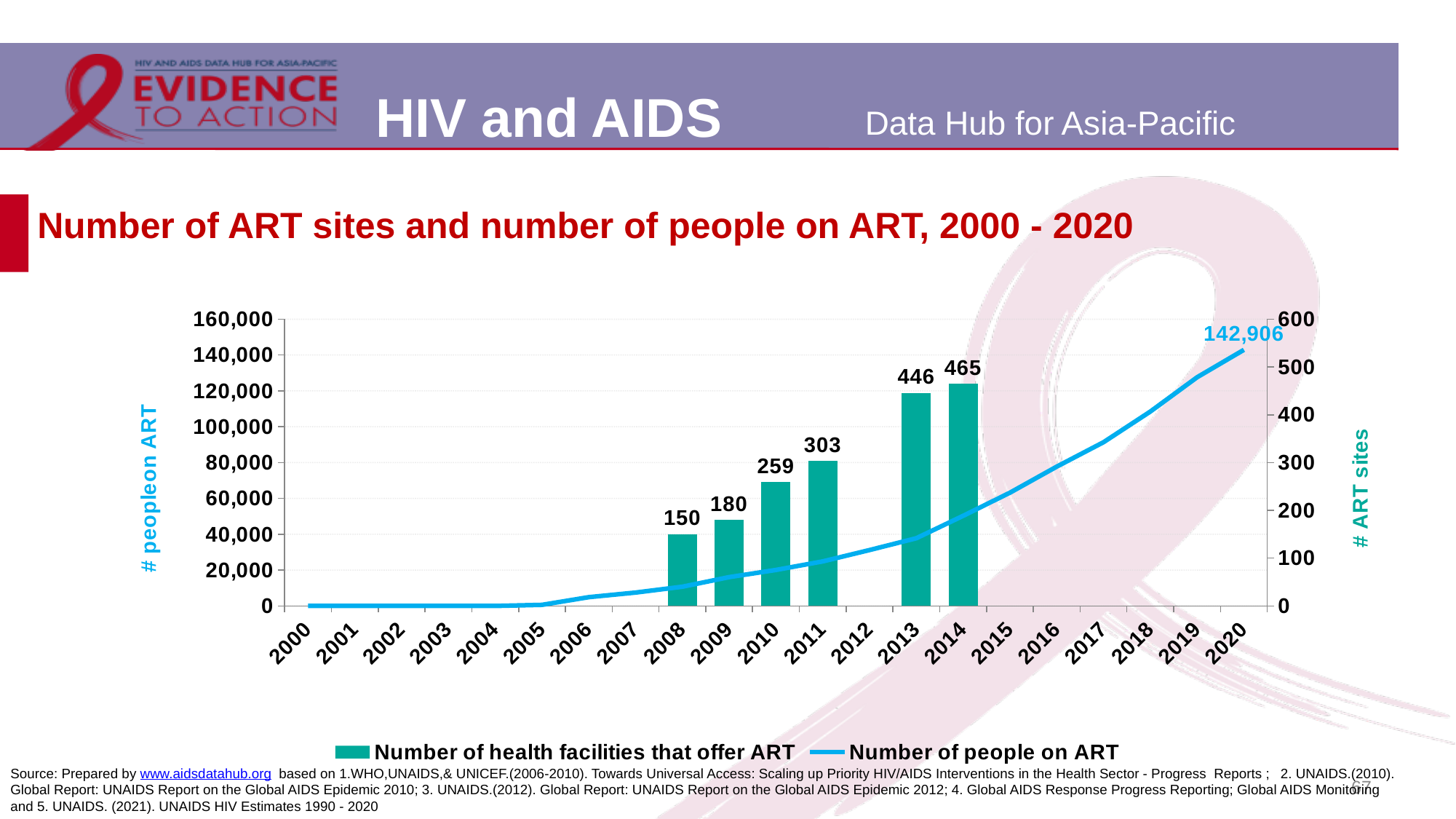
Does the number of people on ART rise or fall from 2005 to 2020? rise What is the number of people on ART in 2020? 142,906 What is the number of health facilities that offer ART in 2011? 303 What is the difference between the number of health facilities that offer ART in 2010 and in 2009? 79 Which year has the lowest labelled number of health facilities that offer ART? 2008 Which year has the highest number of health facilities that offer ART? 2014 What is the number of health facilities that offer ART in 2014? 465 Is the number of people on ART in 2016 greater or less than 60,000? greater How many series does the legend list? 2 Which is larger: the number of health facilities that offer ART in 2011 or in 2013? 2013 What is the difference between the number of health facilities that offer ART in 2014 and in 2013? 19 What is the number of health facilities that offer ART in 2008? 150